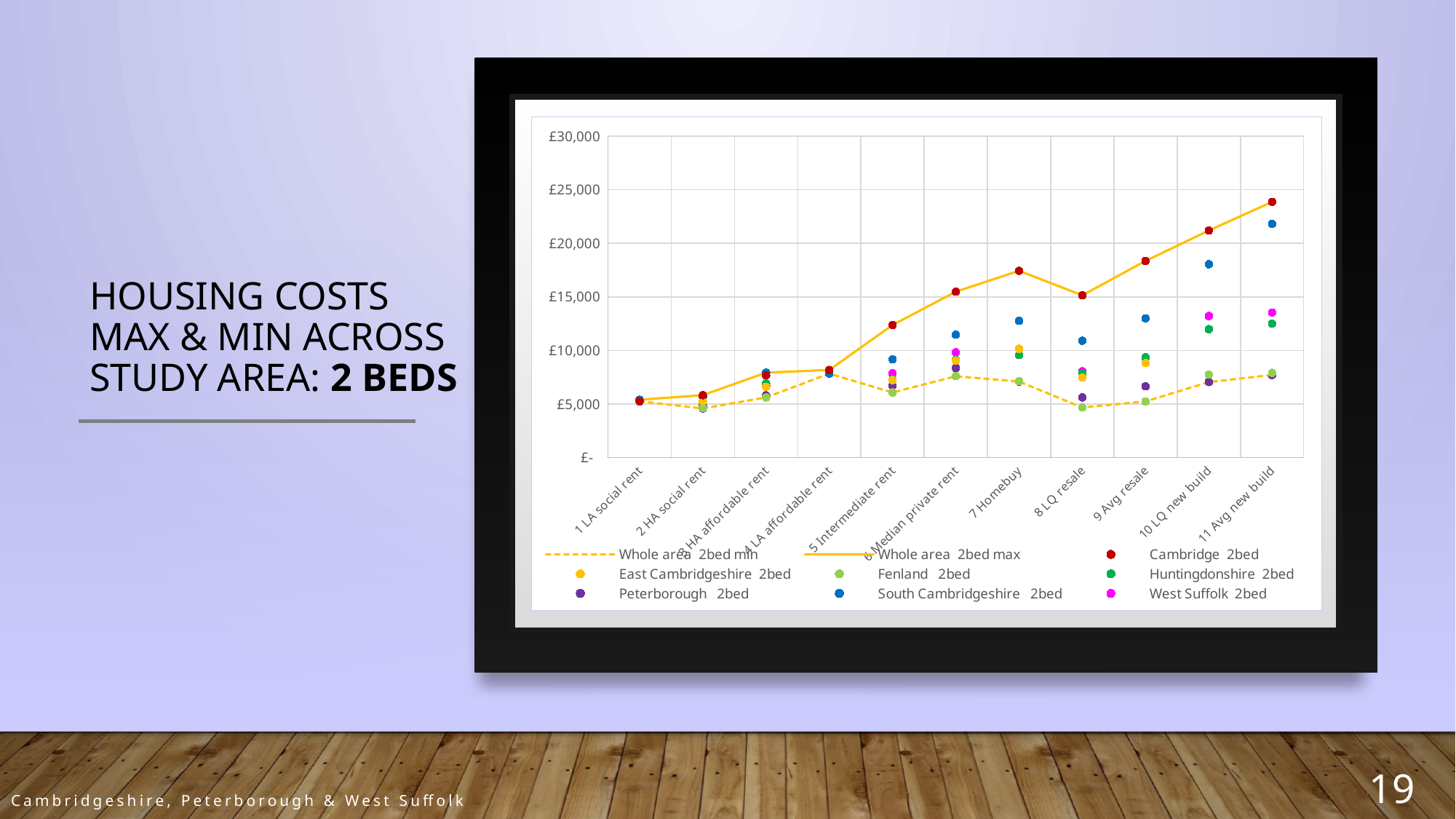
At 10 LQ new build, which is larger: Cambridge 2bed or South Cambridgeshire 2bed? Cambridge 2bed Is the value for South Cambridgeshire 2bed at 11 Avg new build greater or less than £20,000? greater Which series has the lowest value at 8 LQ resale? Fenland 2bed Is the value for Peterborough 2bed at 9 Avg resale greater or less than £10,000? less How many categories are shown on the x axis of the chart? 11 What kind of chart is shown on the slide? line chart At which category does Cambridge 2bed reach its highest value? 11 Avg new build Which series has the highest value at 11 Avg new build? Cambridge 2bed Is the value for Cambridge 2bed at 11 Avg new build greater or less than £20,000? greater How many series does the chart's legend list? 9 Does the Whole area 2bed max line rise or fall from 8 LQ resale to 11 Avg new build? rise